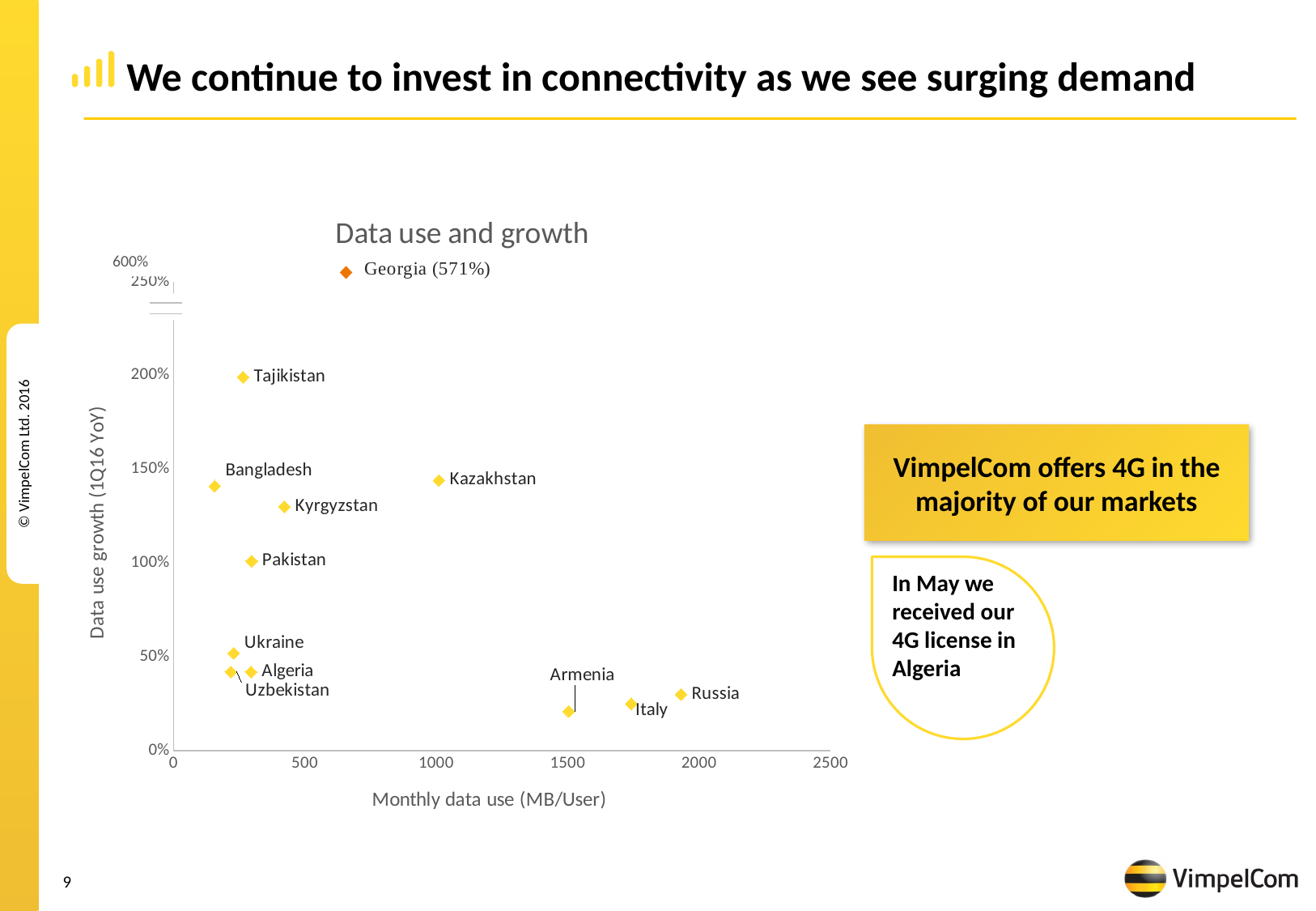
Which country has the highest monthly data use (MB/User) in the chart? Russia Which country has the highest data use growth in the chart? Georgia What is the label of the x axis of the chart? Monthly data use (MB/User) Is the data use growth for Tajikistan greater or less than 150%? greater What is the data use growth value printed for Georgia? 571% How many countries are plotted in the chart? 12 Which country has the lowest monthly data use (MB/User) in the chart? Bangladesh Is the monthly data use for Russia greater or less than 1500 MB/User? greater Is the data use growth for Armenia greater or less than 50%? less What is the title of the chart? Data use and growth What kind of chart is shown on the slide? Scatter chart Which has the higher data use growth, Tajikistan or Pakistan? Tajikistan